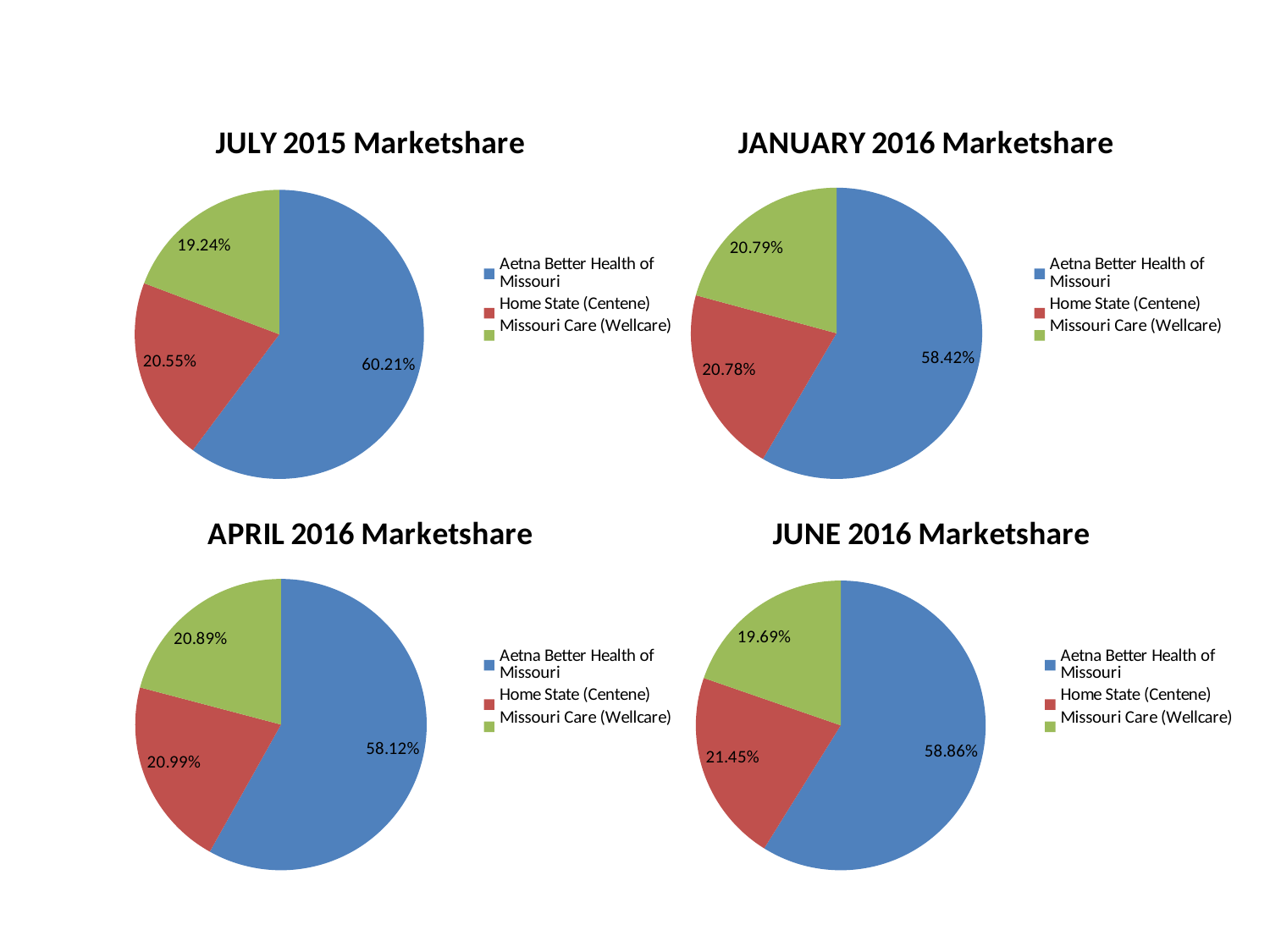
How many charts are shown on the slide? 4 In the APRIL 2016 Marketshare chart, what share does Missouri Care (Wellcare) hold? 20.89% In the JUNE 2016 Marketshare chart, which company has the largest slice? Aetna Better Health of Missouri How many slices does the JANUARY 2016 Marketshare pie chart have? 3 In the JULY 2015 Marketshare chart, what is the difference between the Aetna Better Health of Missouri share and the Home State (Centene) share? 39.66% In the JUNE 2016 Marketshare chart, which is larger: Home State (Centene) or Missouri Care (Wellcare)? Home State (Centene) In the JULY 2015 Marketshare chart, which company has the smallest slice? Missouri Care (Wellcare) In the JUNE 2016 Marketshare chart, what share does Home State (Centene) hold? 21.45% In the JANUARY 2016 Marketshare chart, what share does Home State (Centene) hold? 20.78% In the JUNE 2016 Marketshare chart, what is the difference between the Home State (Centene) share and the Missouri Care (Wellcare) share? 1.76% In the JULY 2015 Marketshare chart, what share does Aetna Better Health of Missouri hold? 60.21% What kind of chart is the APRIL 2016 Marketshare chart? Pie chart